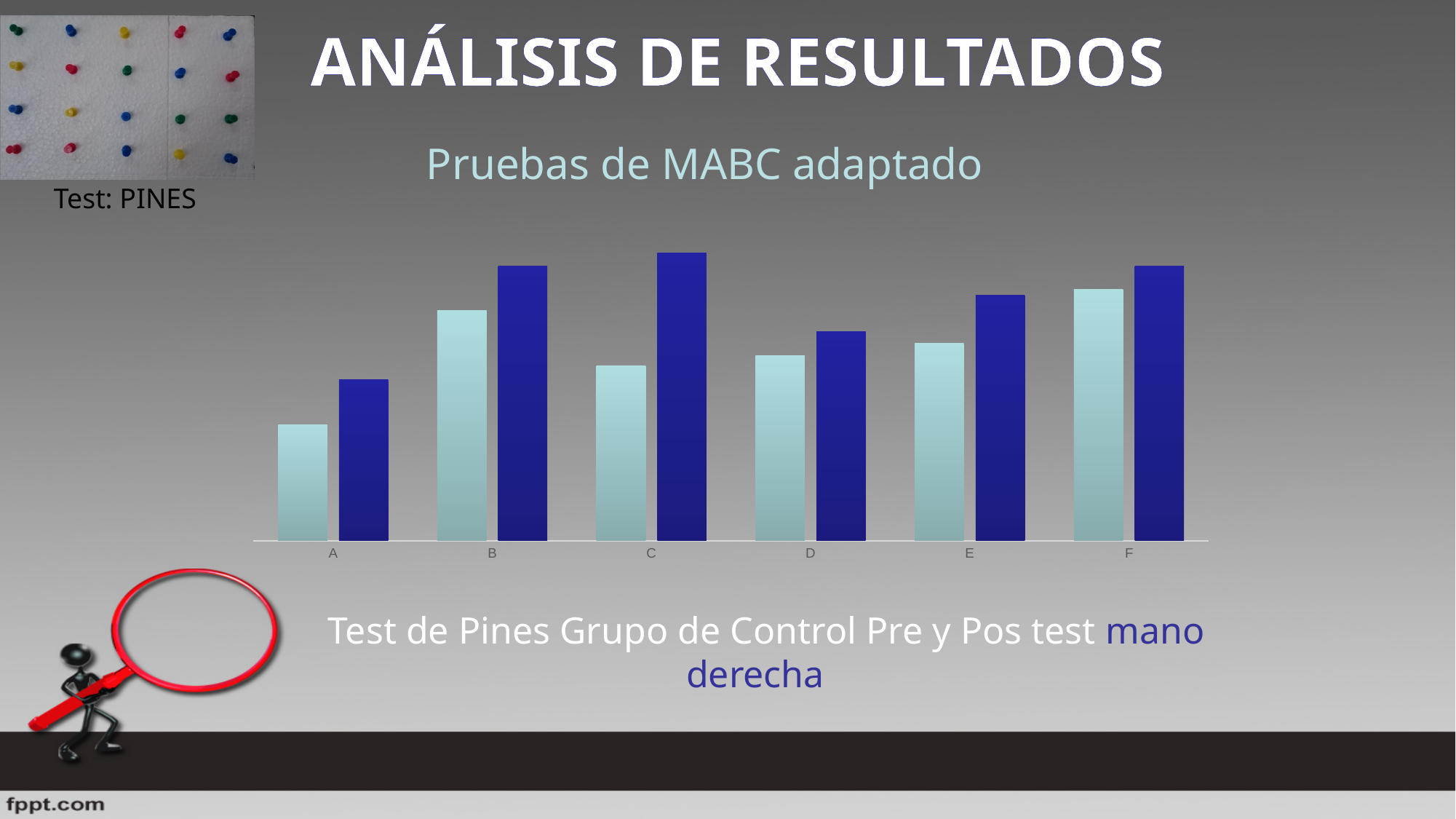
Which category has the shortest light blue bar? A What are the two colours of the bars in the chart? light blue and dark blue Which is taller, the light blue bar for A or the light blue bar for B? B Which is taller, the dark blue bar for D or the dark blue bar for E? E How many bars are plotted for each category in the chart? 2 Which category has the tallest light blue bar? F How many categories are shown along the x axis of the chart? 6 Which category has the tallest dark blue bar? C What caption appears below the chart? Test de Pines Grupo de Control Pre y Pos test mano derecha What kind of chart is shown on the slide? bar chart In category A, which bar is taller, the light blue bar or the dark blue bar? the dark blue bar Which category has the shortest dark blue bar? A